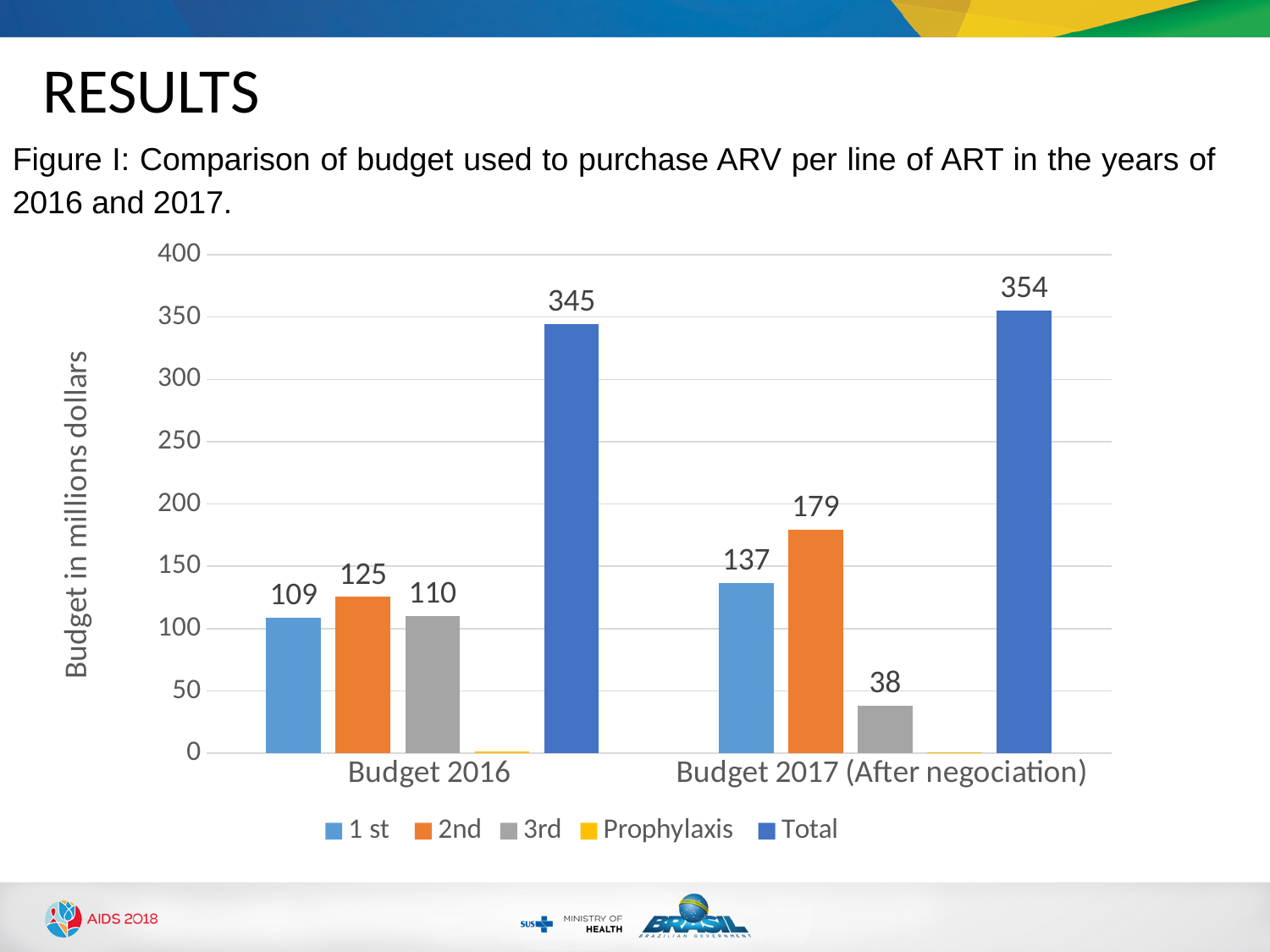
What is the Total value for Budget 2016? 345 How many series does the legend list? 5 What kind of chart is shown on the slide? Bar chart What is the label of the vertical axis? Budget in millions dollars Which is larger: the 2nd series for Budget 2016 or the 2nd series for Budget 2017 (After negociation)? Budget 2017 (After negociation) What is the difference between the Total for Budget 2017 (After negociation) and the Total for Budget 2016? 9 Is the value of the 3rd series for Budget 2016 greater or less than 100? greater What is the value of the 1st series for Budget 2016? 109 Which series has the highest value for Budget 2017 (After negociation)? Total Excluding Total, which series has the lowest labelled value for Budget 2017 (After negociation)? 3rd What is the value of the 2nd series for Budget 2017 (After negociation)? 179 What is the value of the 3rd series for Budget 2017 (After negociation)? 38